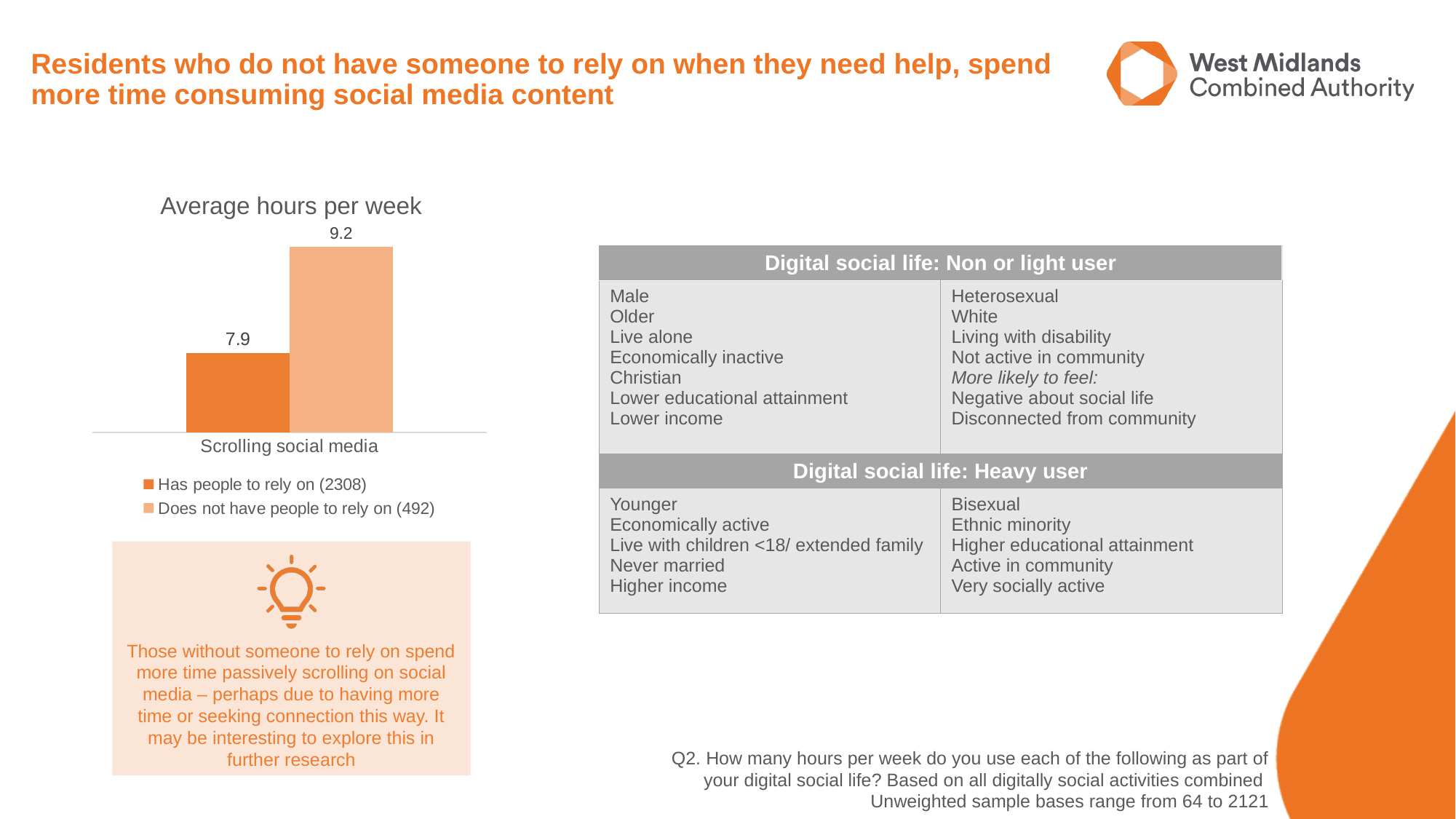
How many series does the chart legend list? 2 What is the average hours per week spent scrolling social media for those who have people to rely on? 7.9 What is the category label on the x axis of the chart? Scrolling social media What is the title of the chart? Average hours per week Which group spends more hours per week scrolling social media? Does not have people to rely on (492) Is the value for 'Has people to rely on' larger or smaller than the value for 'Does not have people to rely on'? smaller What is the average hours per week spent scrolling social media for those who do not have people to rely on? 9.2 What is the difference in average hours per week scrolling social media between those who do not have people to rely on and those who do? 1.3 What kind of chart is shown on the slide? bar chart How many categories are shown on the x axis of the chart? 1 Which group spends fewer hours per week scrolling social media? Has people to rely on (2308)